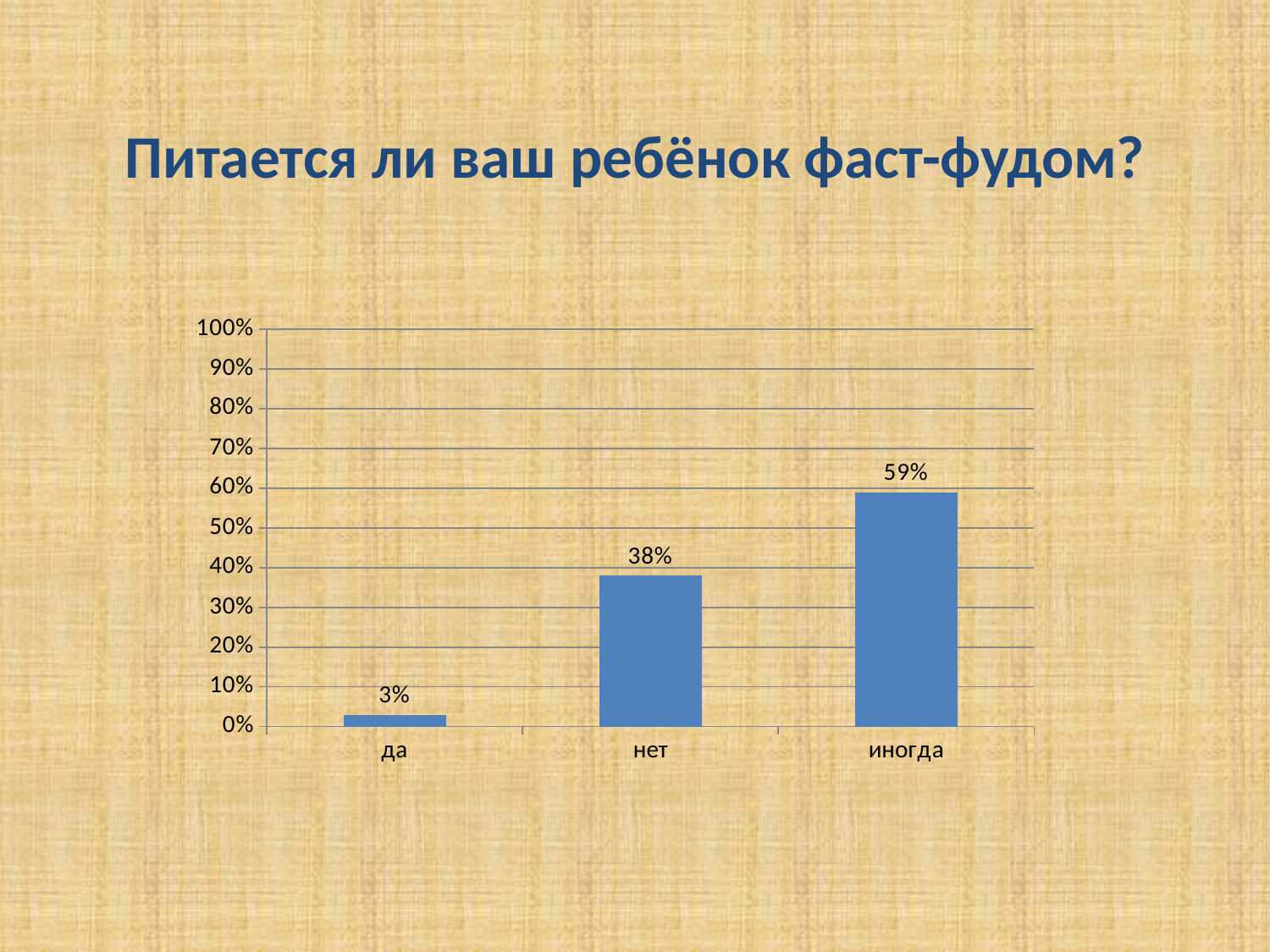
What is the value for "да"? 3% Is the value for "иногда" greater or less than 50%? greater What kind of chart is shown on the slide? bar chart Which is larger, the value for "нет" or the value for "да"? нет What is the value for "нет"? 38% Which category has the lowest value? да What is the difference between the values for "нет" and "да"? 35% What is the difference between the values for "иногда" and "нет"? 21% Which category has the highest value? иногда What is the title of the slide? Питается ли ваш ребёнок фаст-фудом? How many categories are shown on the x axis? 3 What is the value for "иногда"? 59%